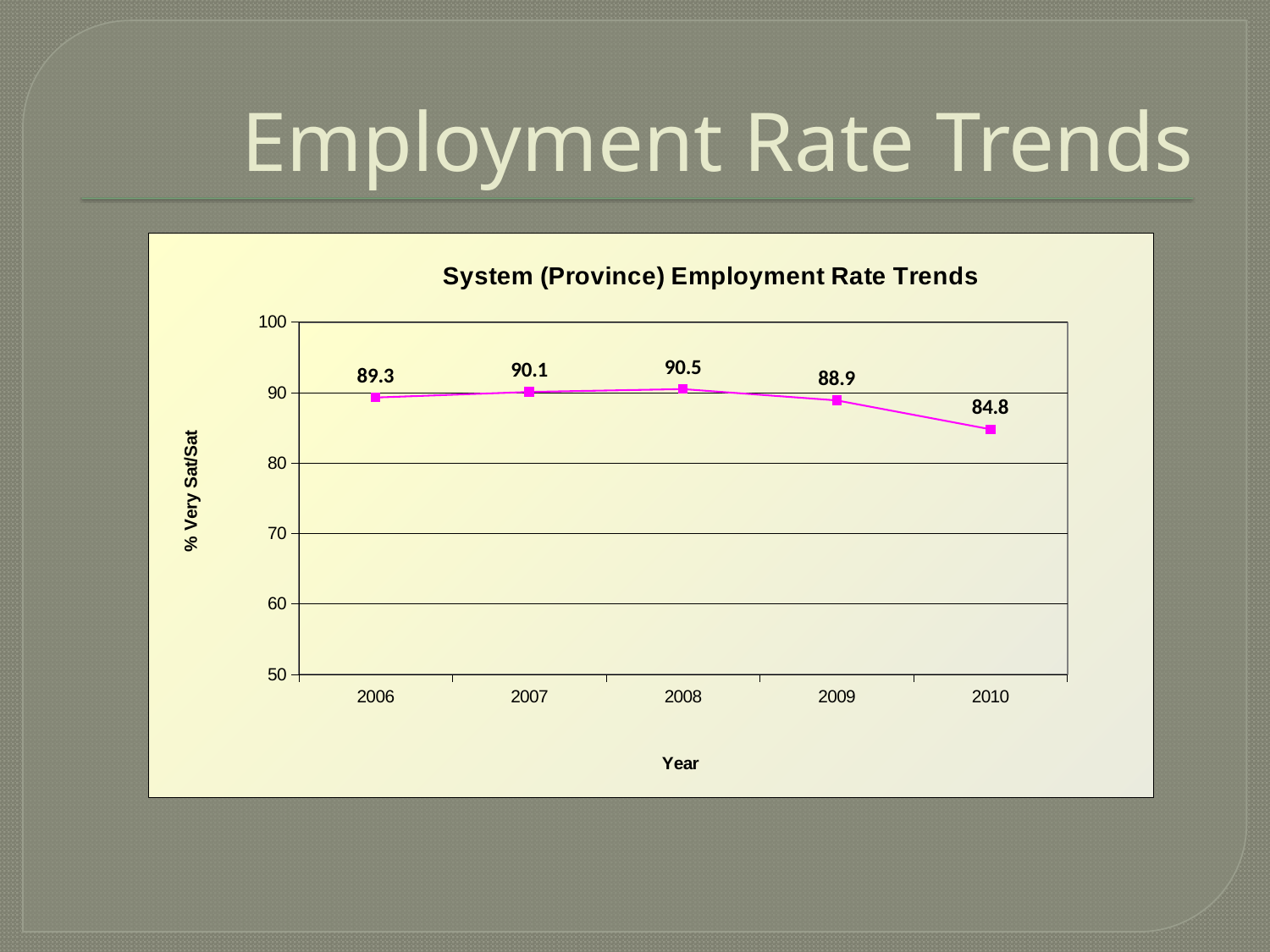
What is the difference between the 2007 value and the 2006 value? 0.8 What is the difference between the 2008 value and the 2010 value? 5.7 Which year has the highest employment rate? 2008 Is the value for 2010 greater or less than 90? less How many years are plotted on the chart? 5 Which year has a larger value, 2009 or 2010? 2009 What is the employment rate value for 2008? 90.5 What kind of chart is shown on the slide? line chart What is the employment rate value for 2006? 89.3 What is the employment rate value for 2010? 84.8 What is the title of the chart? System (Province) Employment Rate Trends Which year has the lowest employment rate? 2010